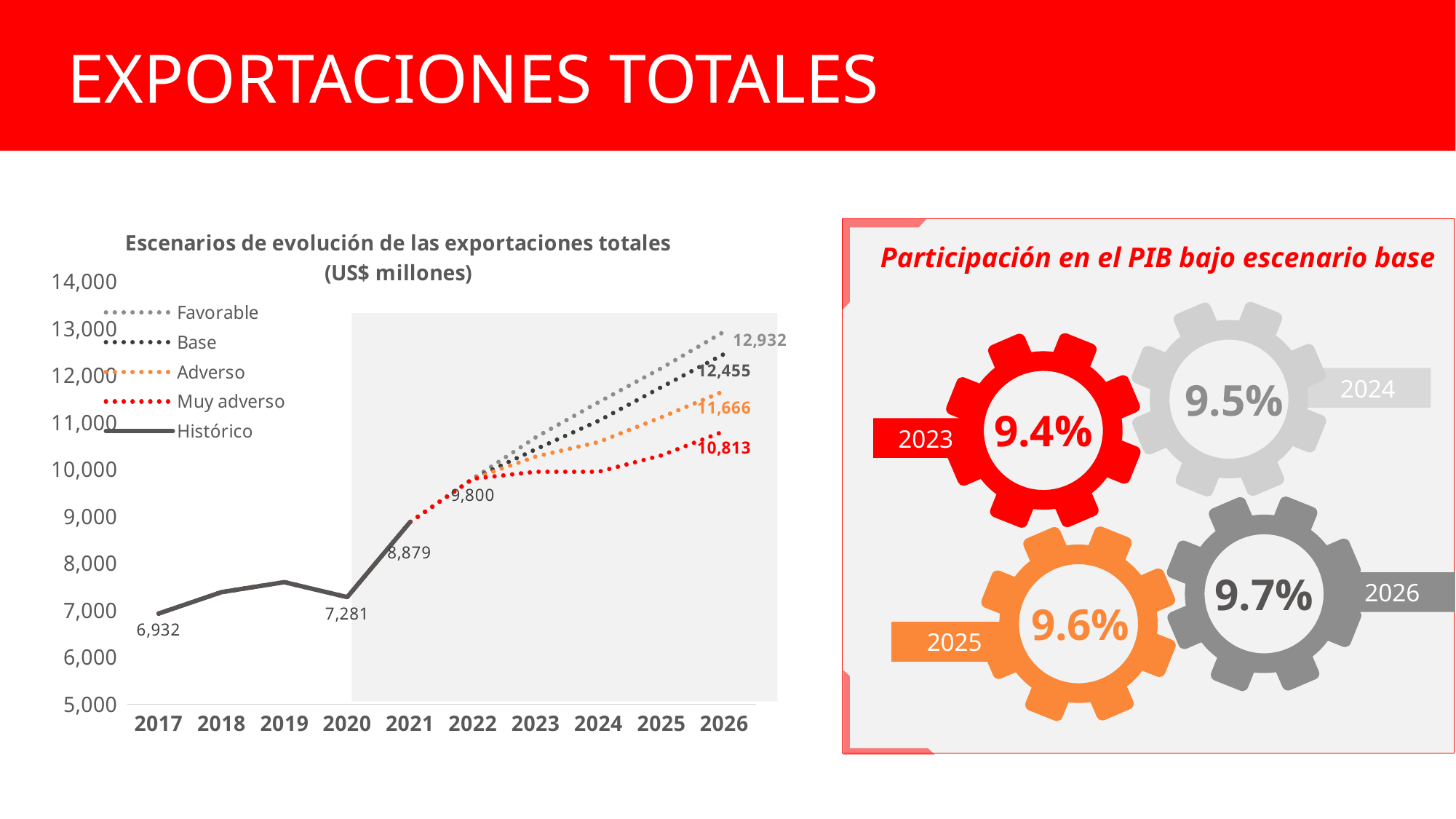
What is the value of the Favorable scenario in 2026? 12,932 How many series does the legend list? 5 Which scenario has the lowest value in 2026? Muy adverso What kind of chart is shown on the slide? line chart What is the difference between the Favorable and Muy adverso values in 2026? 2,119 Which scenario has the highest value in 2026? Favorable What was the value of total exports in 2017? 6,932 What is the value of the Base scenario in 2026? 12,455 Which year has the larger value, 2017 or 2020? 2020 What is the value of the Muy adverso scenario in 2026? 10,813 Is the value for 2019 greater or less than 8,000? less What is the difference between the Base and Adverso values in 2026? 789